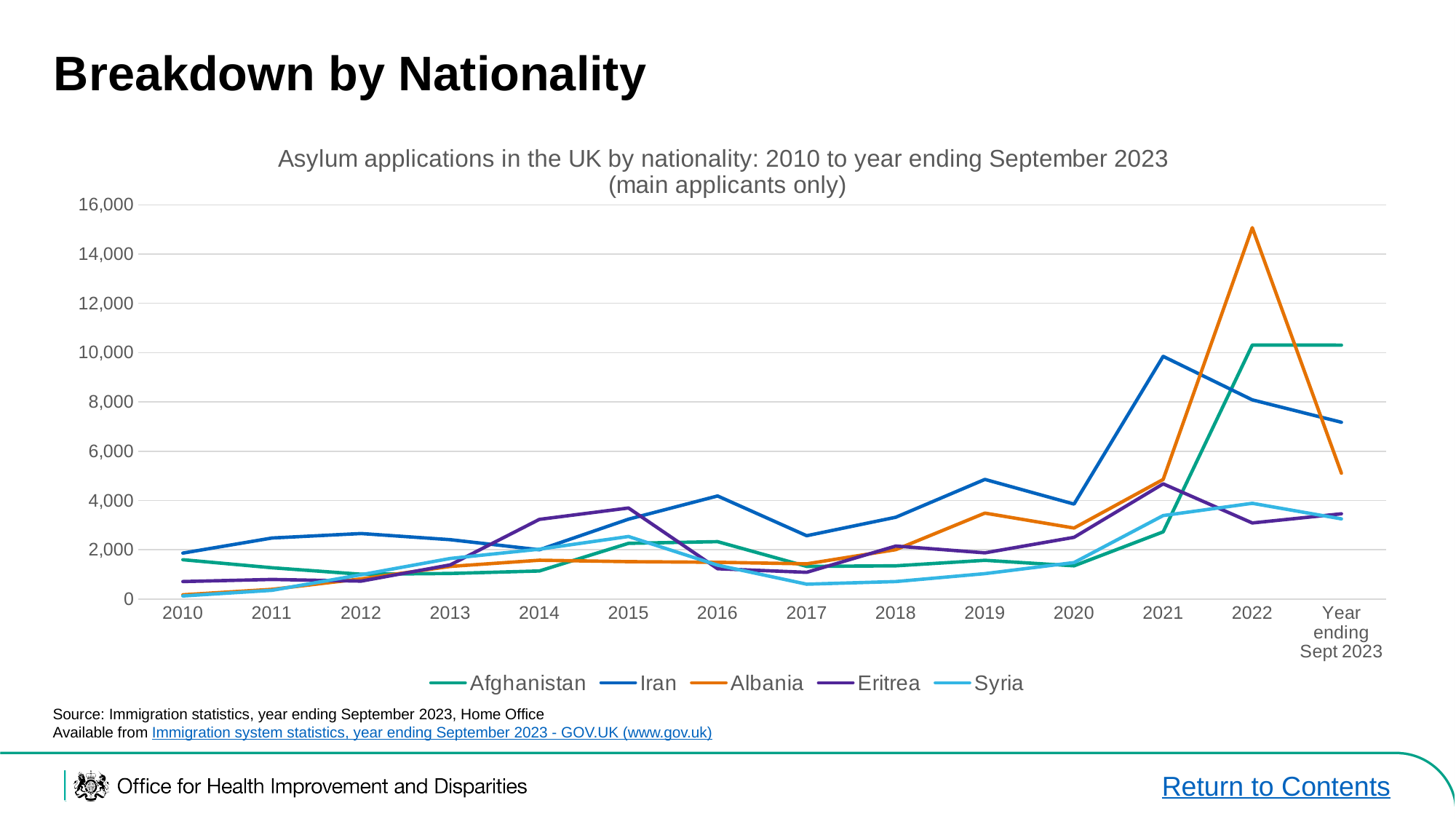
How many nationalities does the legend list? 5 In 2021, which is larger: the value for Iran or the value for Albania? Iran What kind of chart is shown on the slide? line chart Which nationality has the highest value in 2022? Albania What colour is the line for Albania? orange Is the value for Albania in 2022 greater or less than 14,000? greater Is the value for Syria in 2010 greater or less than 2,000? less In the year ending Sept 2023, which is larger: the value for Afghanistan or the value for Iran? Afghanistan Does the value for Iran rise or fall from 2021 to the year ending Sept 2023? fall Is the value for Iran in 2021 greater or less than 8,000? greater How many time points are shown along the x axis? 14 Which nationality has the highest value in 2021? Iran